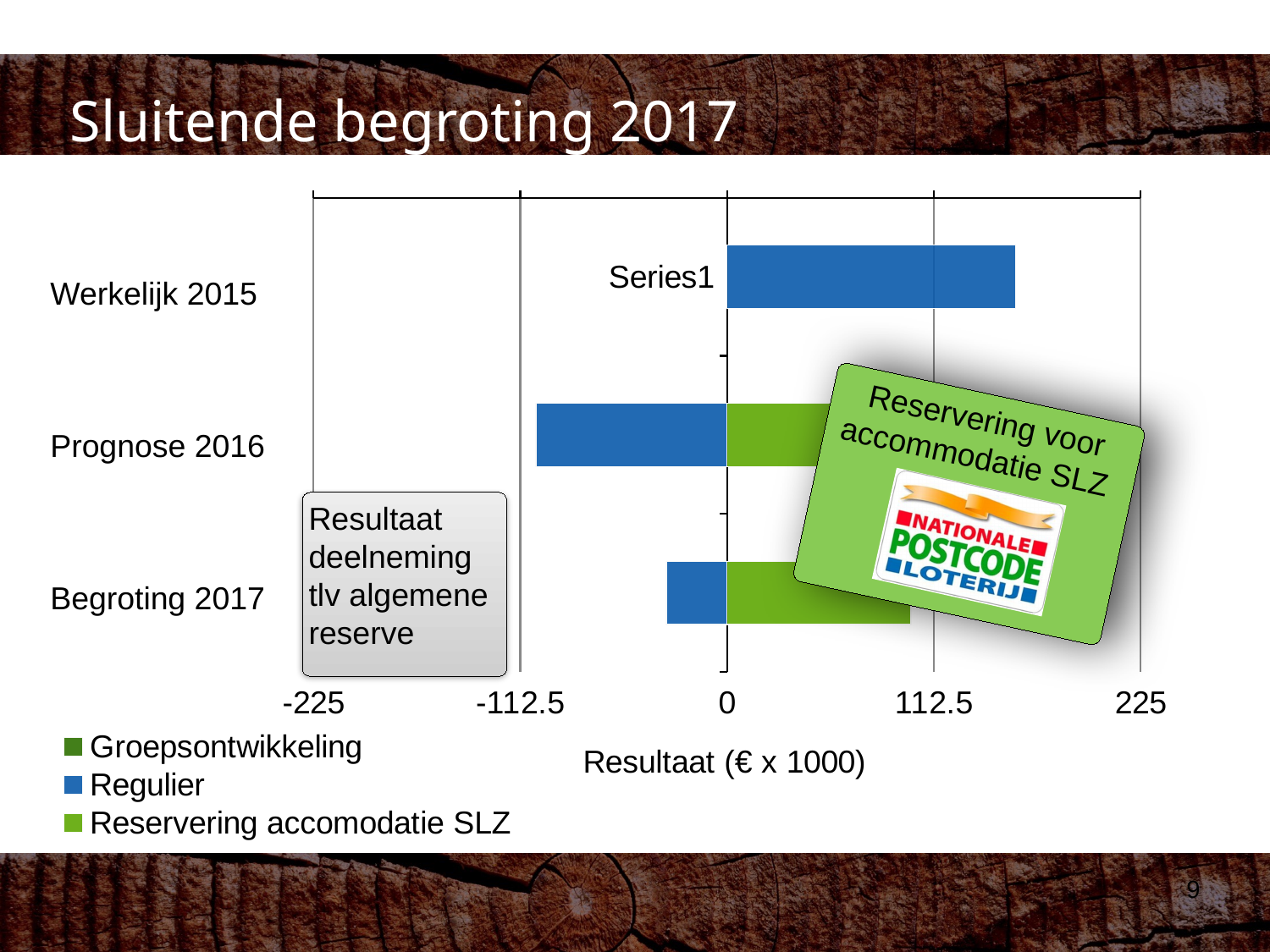
How many series does the chart legend list? 3 Which legend entry is shown in blue? Regulier What is the title of the horizontal axis of the chart? Resultaat (€ x 1000) Which category has the highest Regulier value? Werkelijk 2015 How many categories are shown on the vertical axis of the chart? 3 What kind of chart is shown on the slide? bar chart Is the Regulier value for Werkelijk 2015 greater or less than 112.5? greater Is the Regulier value for Begroting 2017 greater or less than 0? less Which category has the lowest Regulier value? Prognose 2016 Is the Regulier value for Prognose 2016 greater or less than 0? less